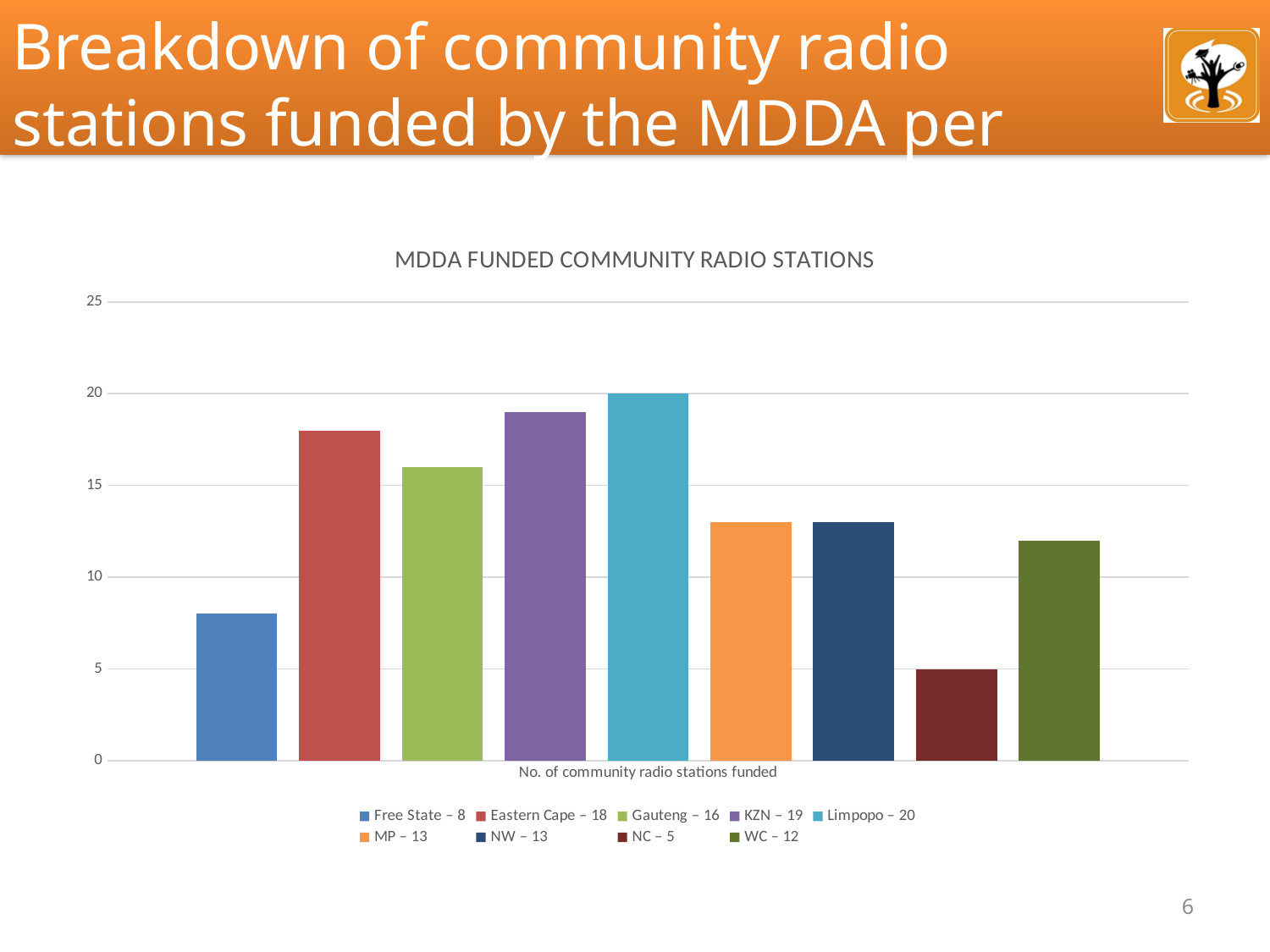
What is the difference between the number of stations funded in Eastern Cape and in Gauteng? 2 What is the title of the chart? MDDA FUNDED COMMUNITY RADIO STATIONS How many community radio stations were funded in Limpopo? 20 How many community radio stations were funded in NC? 5 Which province has the highest number of funded community radio stations? Limpopo How many community radio stations were funded in Free State? 8 How many series does the legend list? 9 What is the x-axis label shown below the bars? No. of community radio stations funded What type of chart is shown on the slide? Bar chart Which province has the lowest number of funded community radio stations? NC Is the value for Eastern Cape greater or less than 15? greater Which has more funded community radio stations, KZN or WC? KZN